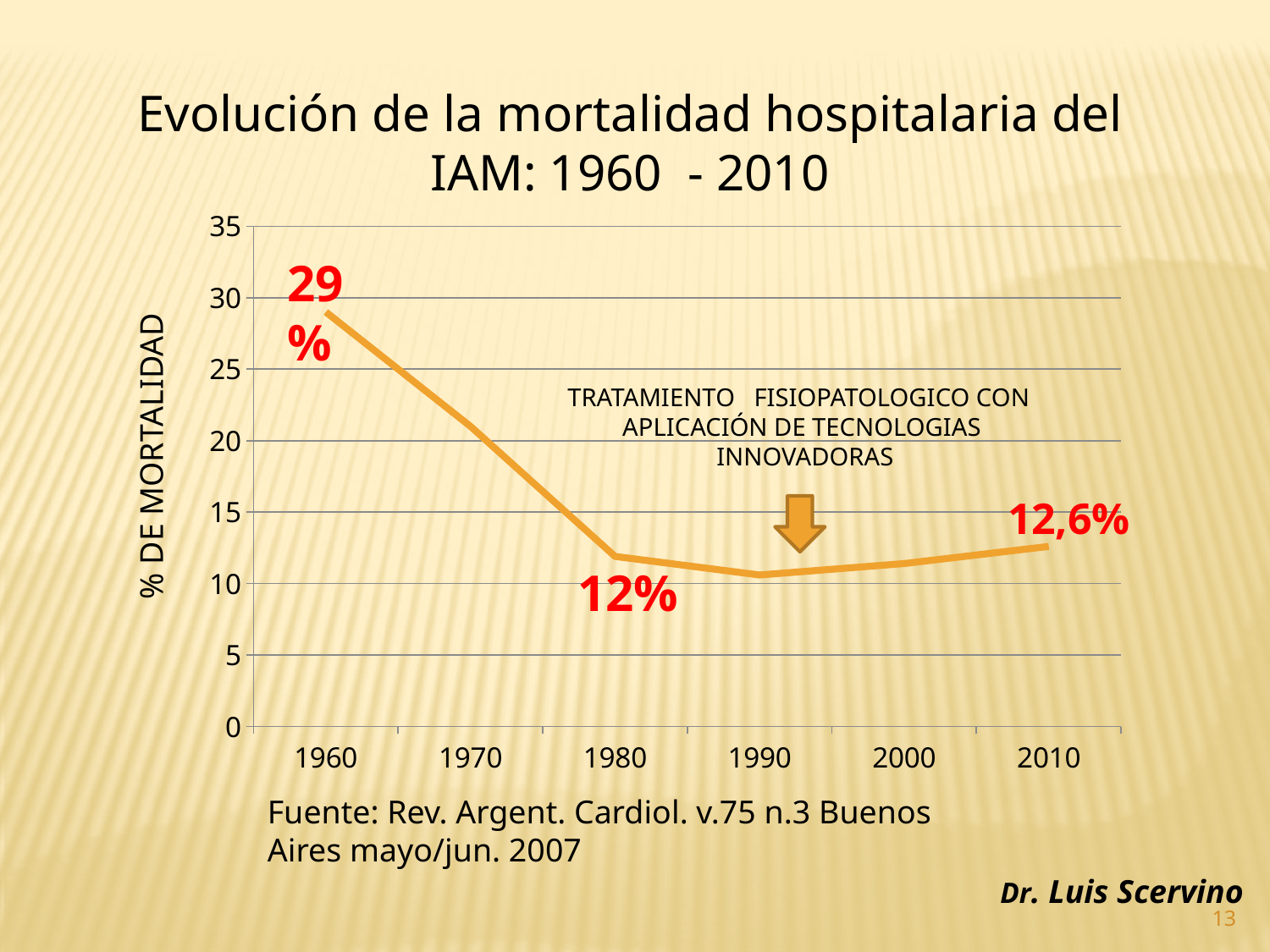
What is the label on the vertical axis of the chart? % DE MORTALIDAD How many years are plotted on the x axis? 6 Which year has the highest mortality value on the chart? 1960 Is the value for 1990 greater or less than 15? less What is the hospital mortality value shown for 1980? 12% What kind of chart is shown on the slide? Line chart Which is larger, the mortality value for 1960 or for 2010? 1960 What is the hospital mortality value shown for 1960? 29% What is the hospital mortality value shown for 2010? 12,6% Does the mortality value rise or fall between 1960 and 1980? Fall Is the value for 1970 greater or less than 25? less What is the difference between the mortality values for 1960 and 1980? 17 percentage points